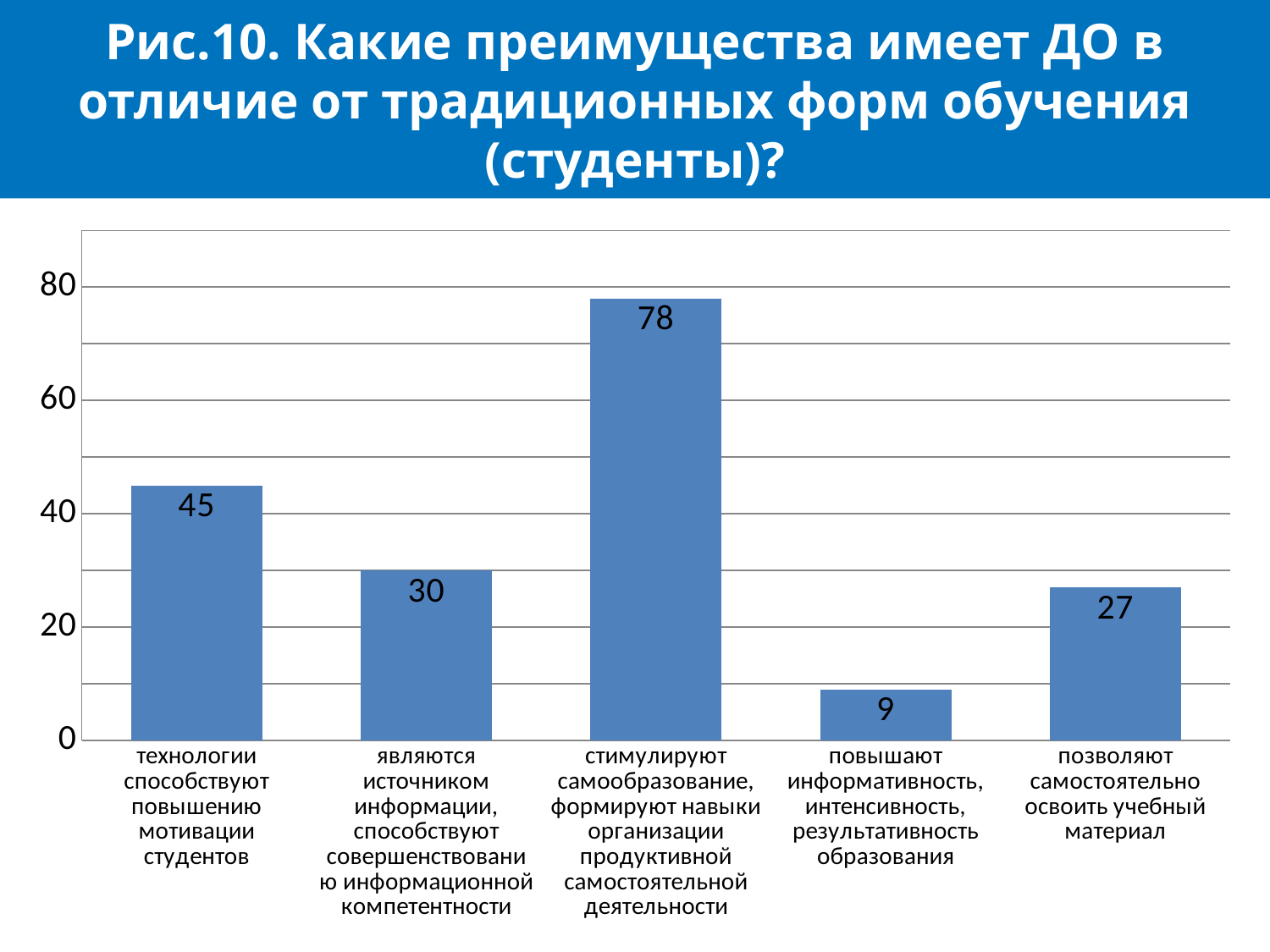
What is the value for "повышают информативность, интенсивность, результативность образования"? 9 Is the value for "стимулируют самообразование..." greater or less than 60? greater What is the value for "технологии способствуют повышению мотивации студентов"? 45 What is the difference between the values for "являются источником информации..." and "позволяют самостоятельно освоить учебный материал"? 3 What is the difference between the values for "стимулируют самообразование..." and "технологии способствуют повышению мотивации студентов"? 33 Which category has the highest value? стимулируют самообразование, формируют навыки организации продуктивной самостоятельной деятельности Which category has the lowest value? повышают информативность, интенсивность, результативность образования Which is larger: the value for "технологии способствуют повышению мотивации студентов" or for "являются источником информации..."? технологии способствуют повышению мотивации студентов How many categories are shown in the chart? 5 What is the title of the slide? Рис.10. Какие преимущества имеет ДО в отличие от традиционных форм обучения (студенты)? What kind of chart is shown on the slide? bar chart What is the value for "позволяют самостоятельно освоить учебный материал"? 27